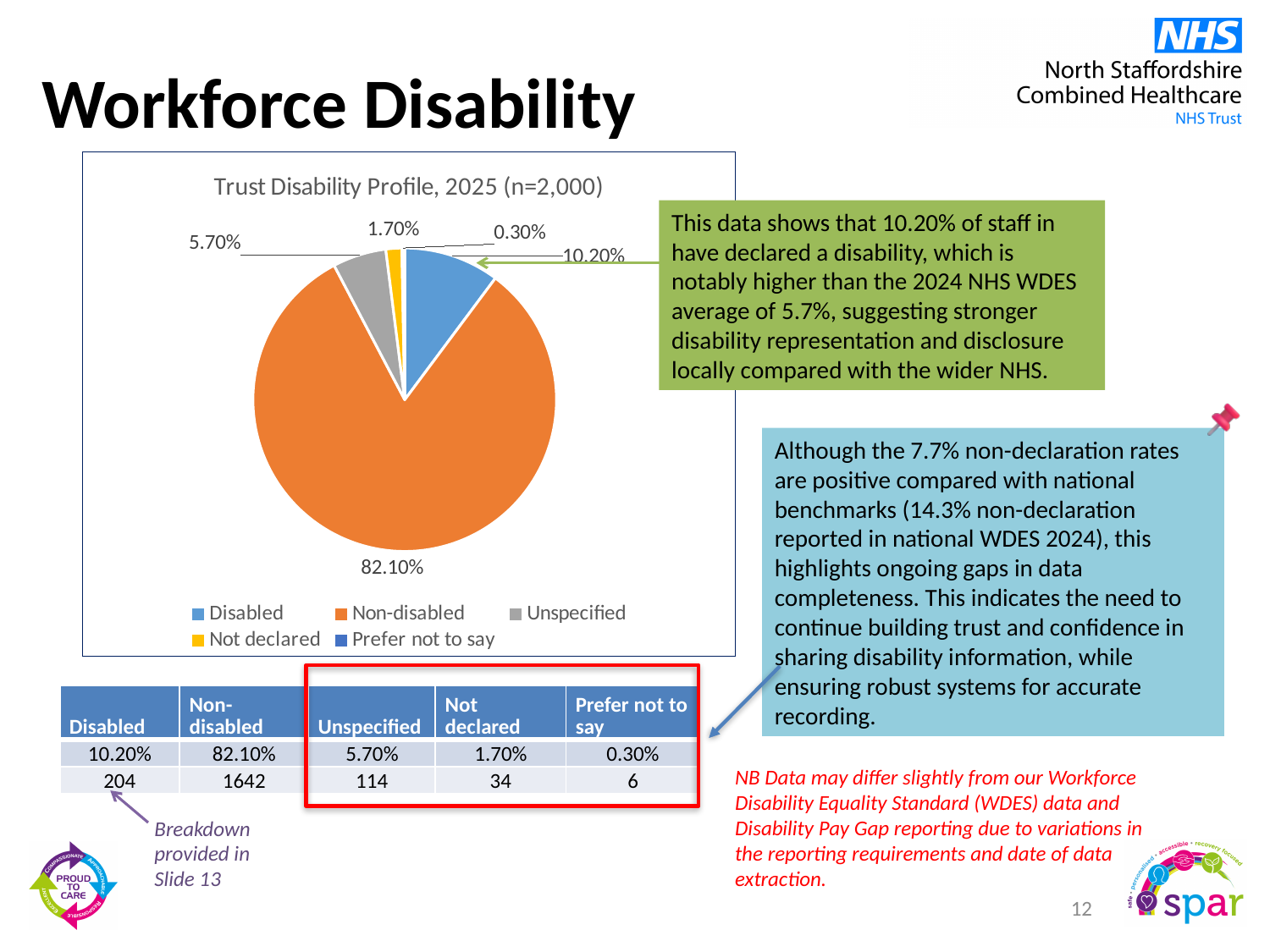
Which category has the largest slice of the pie? Non-disabled What kind of chart is shown on the slide? Pie chart What percentage of the pie is labelled for the Not declared slice? 1.70% What percentage of the pie is labelled for the Unspecified slice? 5.70% What percentage of the pie is labelled for the Disabled slice? 10.20% Which slice is larger, Unspecified or Not declared? Unspecified How many categories does the legend of the pie chart list? 5 What percentage of the pie is labelled for the Non-disabled slice? 82.10% Which category has the smallest slice of the pie? Prefer not to say What is the difference in percentage points between the Disabled slice and the Unspecified slice? 4.50% What is the title of the chart? Trust Disability Profile, 2025 (n=2,000) What percentage of the pie is labelled for the Prefer not to say slice? 0.30%